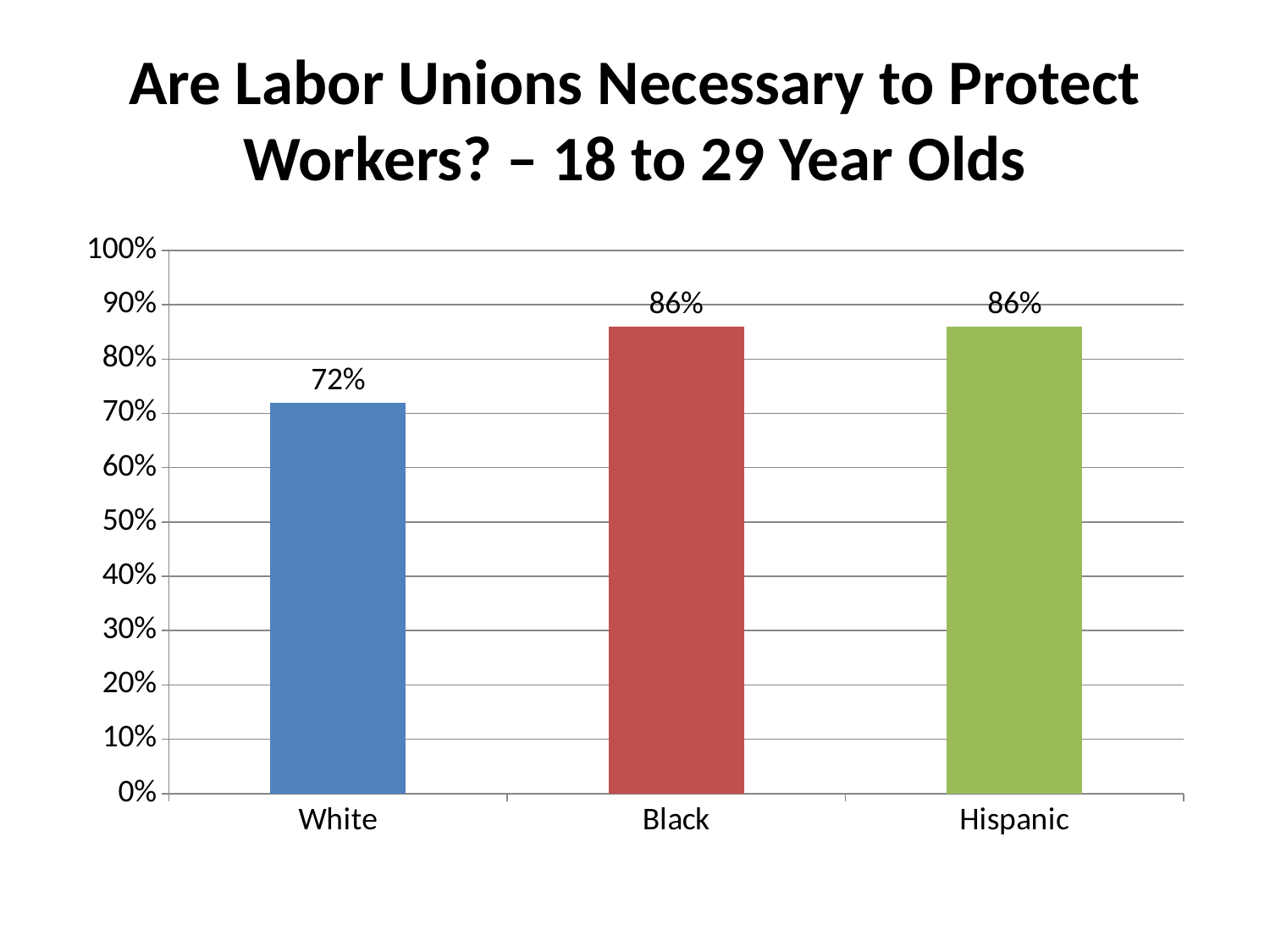
What is the value for Black? 86% Is the value for White greater or less than 80%? less What colour is the bar for Black? red What is the difference between the values for Black and White? 14% What kind of chart is shown on the slide? bar chart How many categories are shown on the x axis? 3 What is the value for Hispanic? 86% What is the title of the slide? Are Labor Unions Necessary to Protect Workers? – 18 to 29 Year Olds What is the value for White? 72% Which category has the lowest value? White Is the value for Black greater or less than 80%? greater Which is larger, the value for White or the value for Hispanic? Hispanic